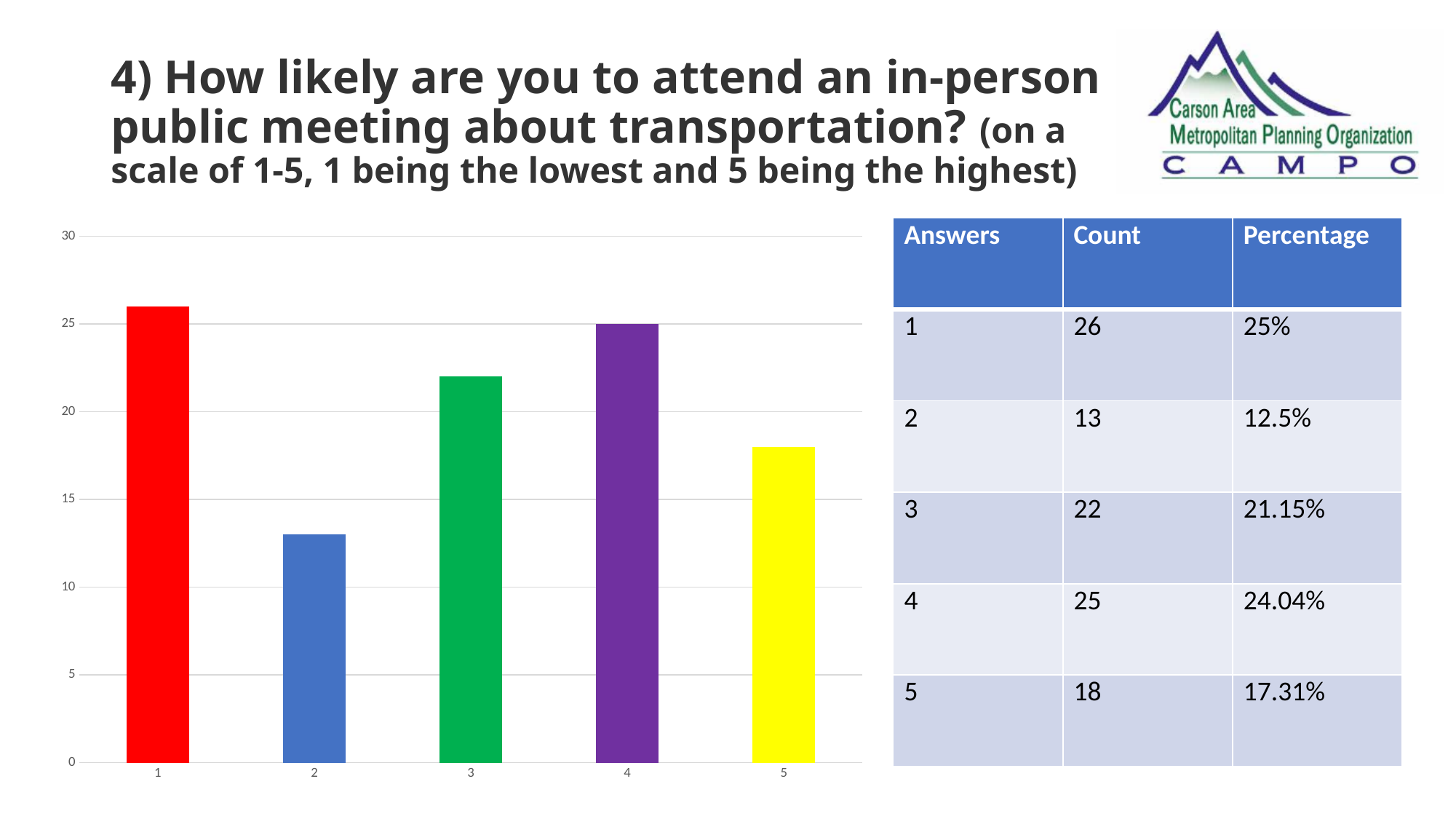
How many categories (answer options) are plotted in the bar chart? 5 Which answer option has the highest bar in the chart? 1 What is the count for answer 4? 25 What is the count for answer 5? 18 What is the count for answer 1? 26 What colour is the bar for answer 4? purple Is the value for answer 3 greater or less than 20? greater What is the difference between the counts for answer 1 and answer 2? 13 Which has a larger count, answer 3 or answer 5? 3 Is the value for answer 2 greater or less than 15? less What kind of chart is shown on the slide? bar chart Which answer option has the lowest bar in the chart? 2